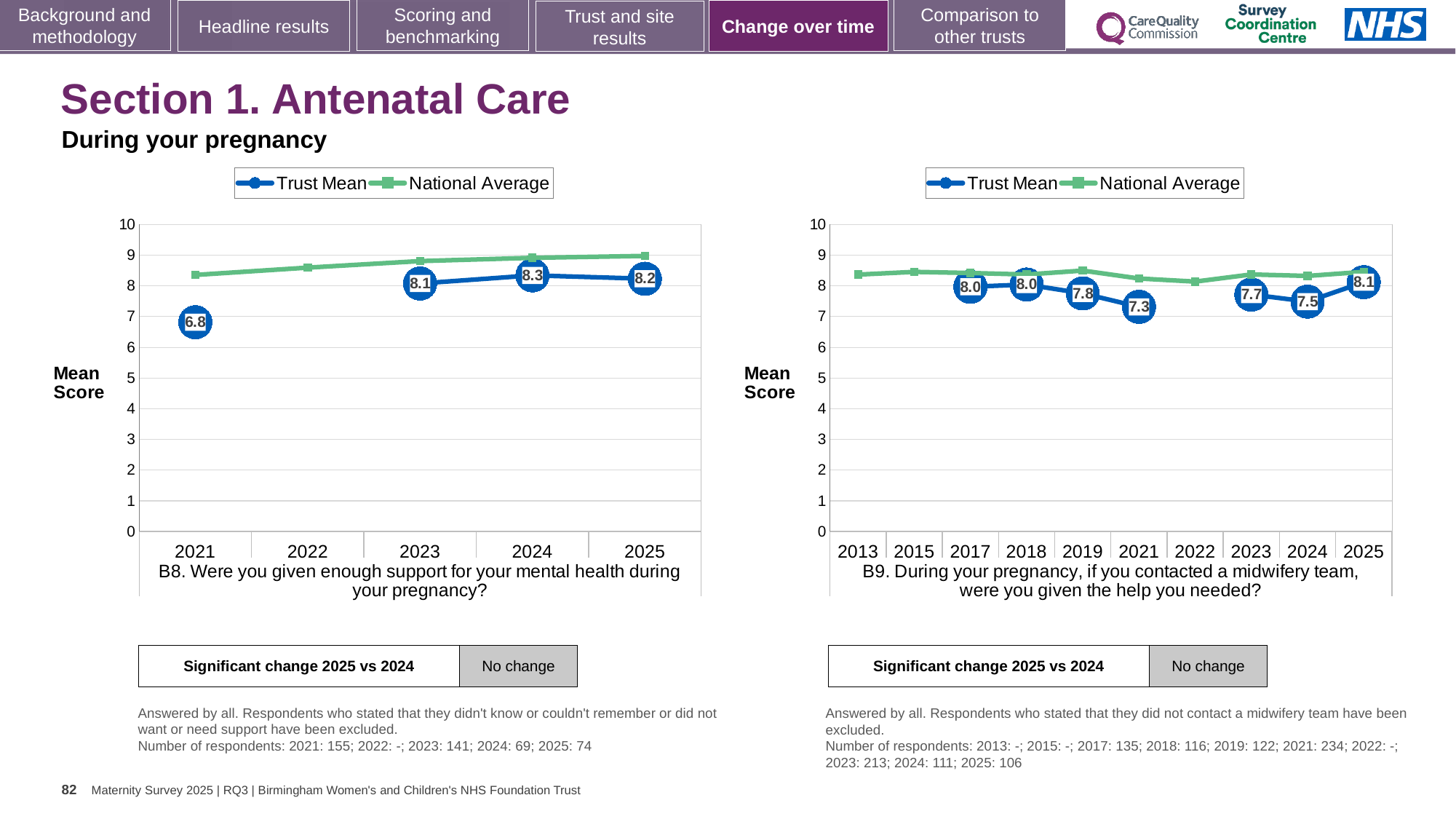
On the right chart (B9), what is the difference between the Trust Mean in 2025 and in 2024? 0.6 How many years are shown on the x axis of the right chart (B9)? 10 What kind of chart is the left chart (B8)? line chart On the left chart (B8), what is the Trust Mean for 2021? 6.8 On the right chart (B9), which year has the highest Trust Mean? 2025 How many series does the legend of the left chart (B8) list? 2 On the right chart (B9), which year has the lowest Trust Mean? 2021 On the left chart (B8), which year has the lowest Trust Mean? 2021 On the left chart (B8), is the National Average for 2021 greater or less than 8? greater On the left chart (B8), what is the difference between the Trust Mean in 2024 and in 2021? 1.5 On the left chart (B8), which year has the highest Trust Mean? 2024 On the right chart (B9), what is the Trust Mean for 2021? 7.3